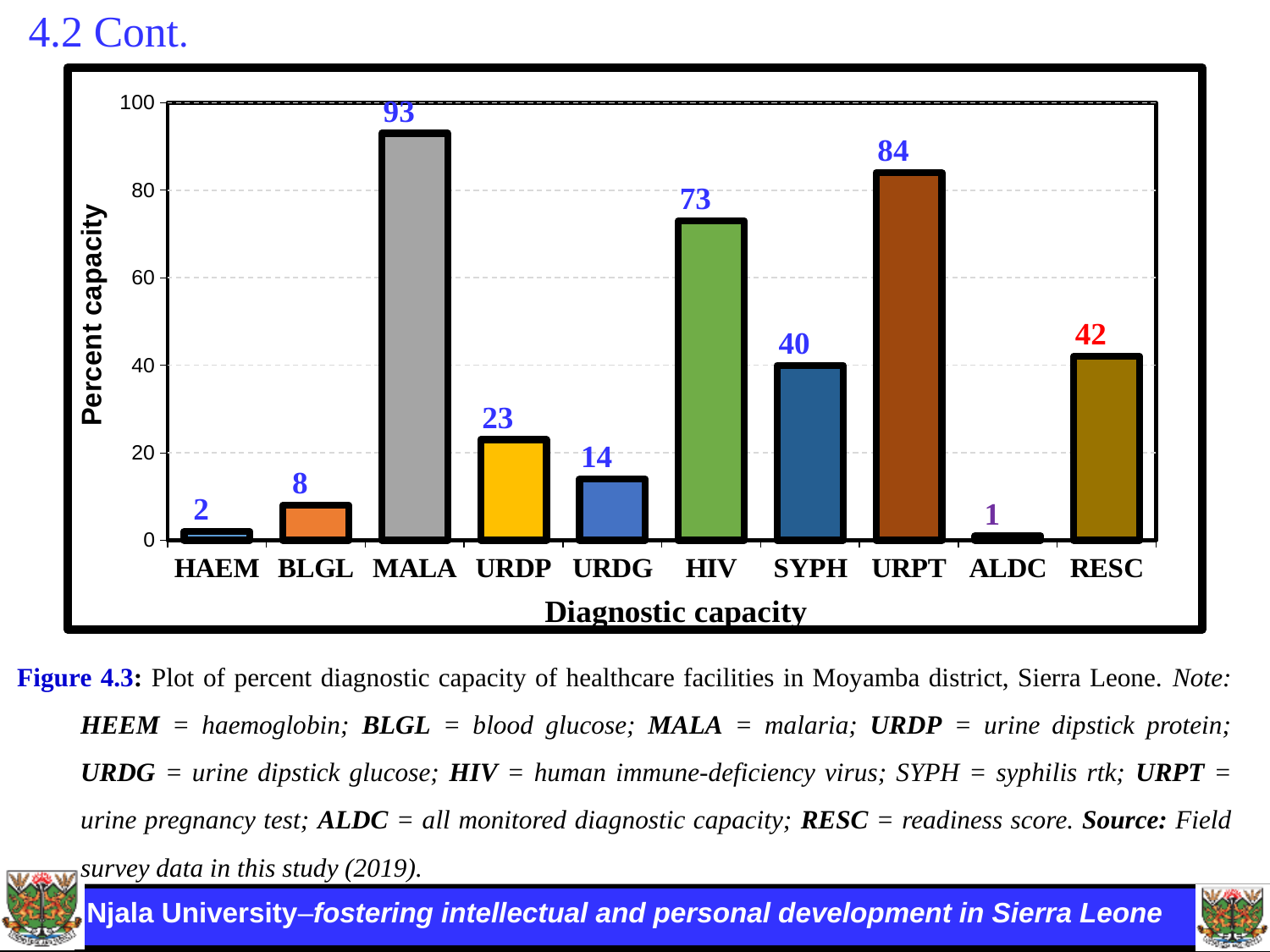
What is the difference in percent capacity between HIV and SYPH? 33 Which diagnostic capacity has the highest percent capacity? MALA How many diagnostic capacity categories are shown on the x axis? 10 Is the value for HIV greater or less than 60? greater What is the percent capacity for MALA? 93 What is the percent capacity for RESC? 42 Which diagnostic capacity has the lowest percent capacity? ALDC What is the percent capacity for URPT? 84 What kind of chart is shown on the slide? bar chart What is the difference in percent capacity between MALA and URPT? 9 Which has a higher percent capacity, URDP or URDG? URDP What is the label of the y axis? Percent capacity